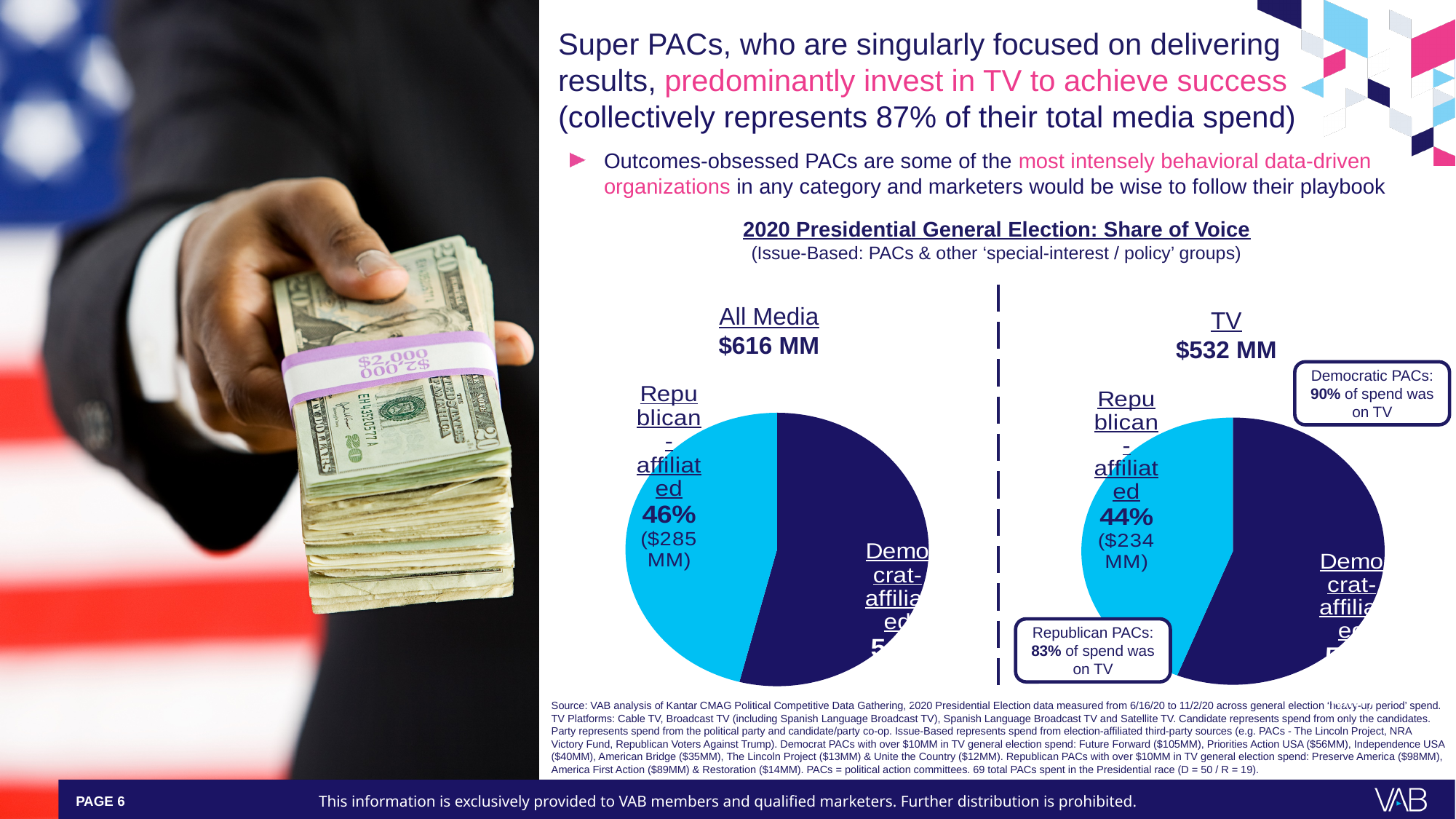
What is the total spend shown for the All Media pie chart? $616 MM In the All Media pie chart, what share of spend is Republican-affiliated? 46% In the TV pie chart, what share of spend is Republican-affiliated? 44% What kind of chart is used for the All Media chart? pie chart What is the total spend shown for the TV pie chart? $532 MM How many slices does the TV pie chart have? 2 In the TV pie chart, what is the dollar amount of Republican-affiliated spend? $234 MM What is the title above the two pie charts? 2020 Presidential General Election: Share of Voice In the All Media pie chart, what is the dollar amount of Republican-affiliated spend? $285 MM Is the Republican-affiliated share larger in the All Media pie chart or the TV pie chart? All Media In the All Media pie chart, which slice is larger, Republican-affiliated or Democrat-affiliated? Democrat-affiliated What is the difference between Republican-affiliated spend in the All Media chart and in the TV chart? $51 MM